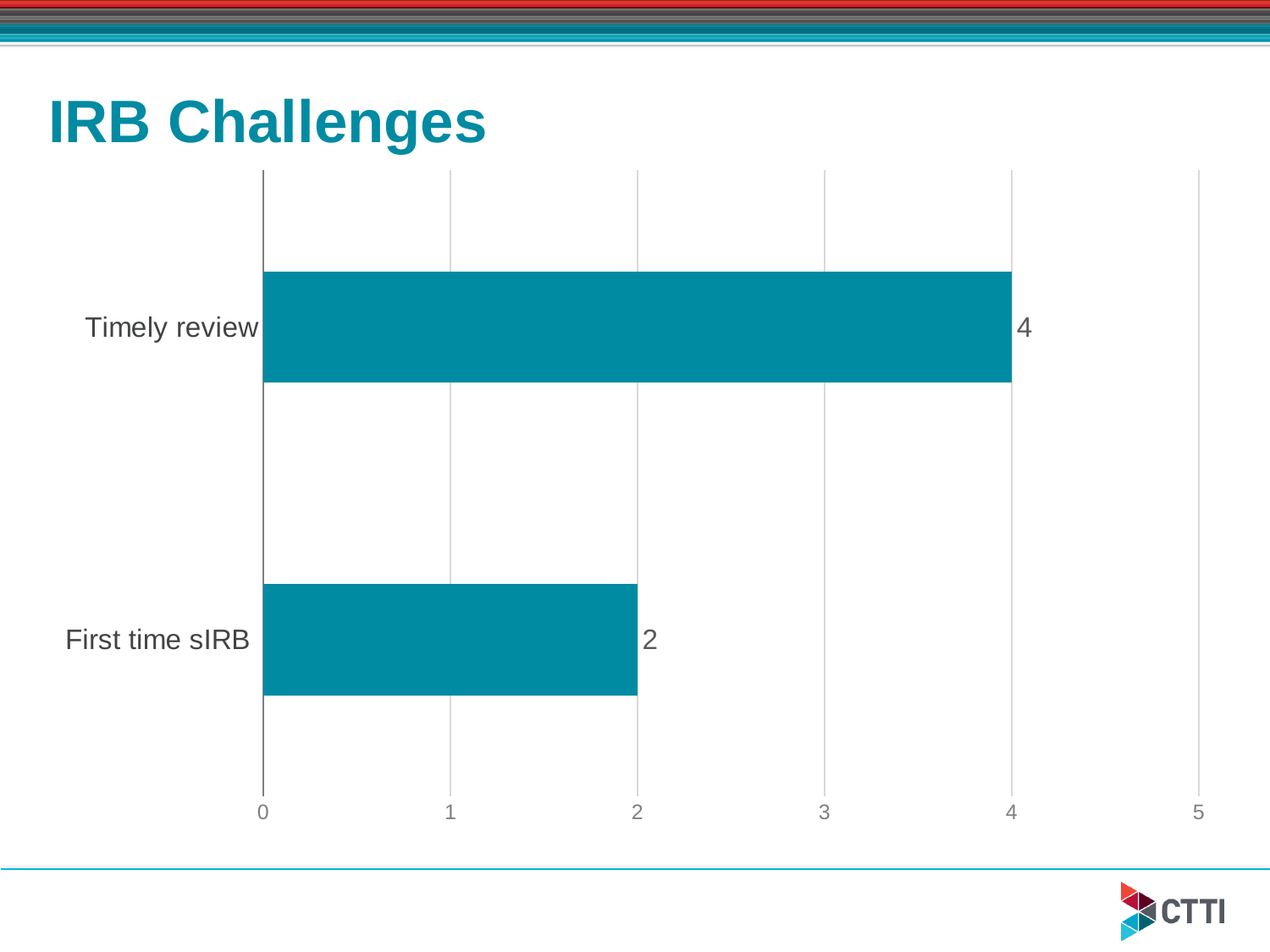
Which category has the highest value? Timely review Is the value for First time sIRB greater or less than 3? less What is the title of the slide? IRB Challenges Is the value for Timely review greater or less than 3? greater Which is larger, the value for Timely review or the value for First time sIRB? Timely review What is the value for First time sIRB? 2 What is the difference between the values for Timely review and First time sIRB? 2 What kind of chart is shown on the slide? bar chart What is the maximum value shown on the horizontal axis? 5 Which category has the lowest value? First time sIRB How many categories are shown in the chart? 2 What is the value for Timely review? 4